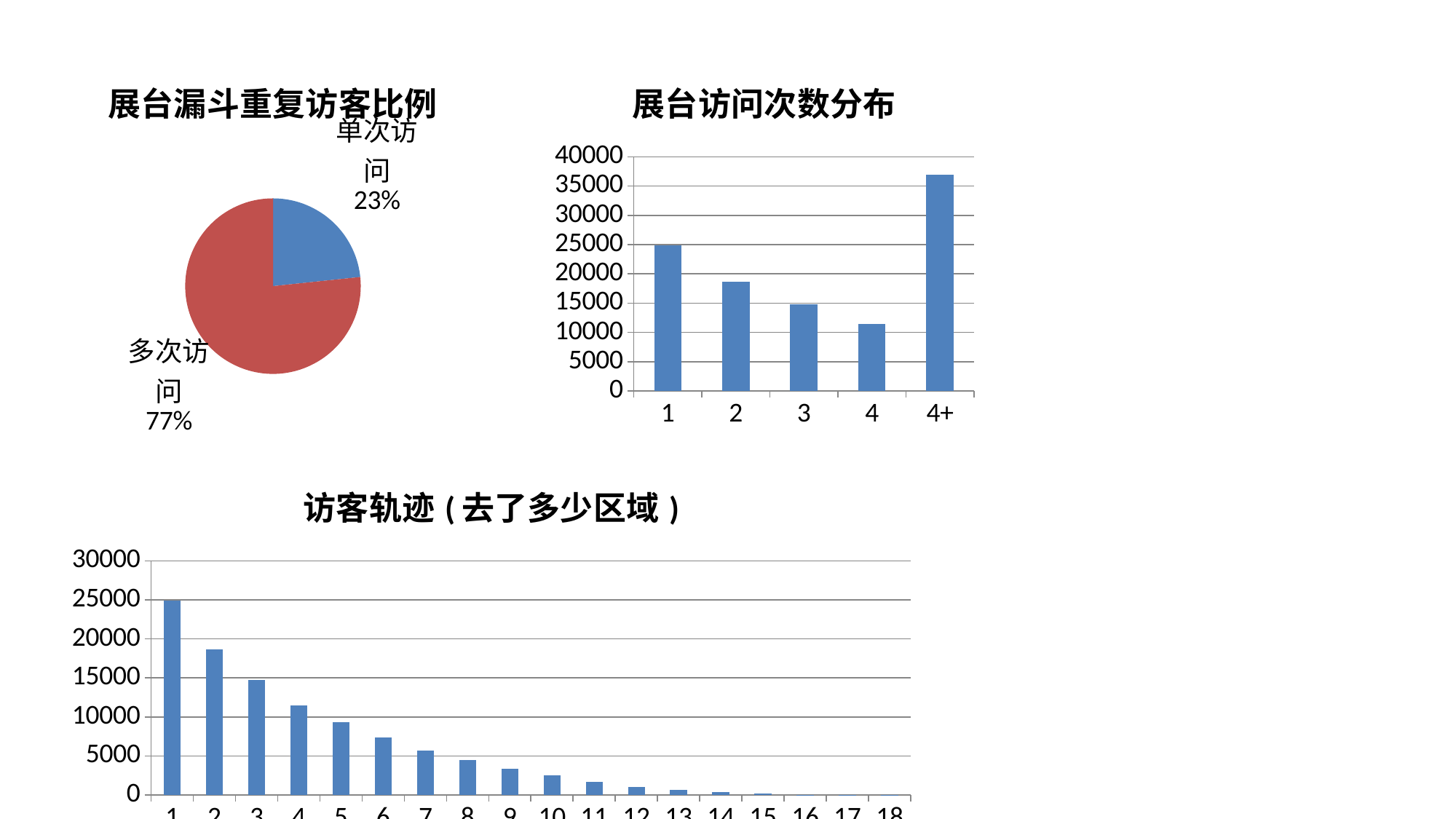
How many categories are shown on the x axis of the chart titled 访客轨迹（去了多少区域）? 18 What kind of chart is the one titled 访客轨迹（去了多少区域）? bar chart In the chart titled 展台访问次数分布, is the value for category 4+ greater or less than 35000? greater In the chart titled 展台访问次数分布, which category has the highest value? 4+ In the chart titled 展台漏斗重复访客比例, what percentage is shown for 单次访问? 23% In the chart titled 展台访问次数分布, which category has the lowest value? 4 In the chart titled 展台访问次数分布, is the value for category 1 greater or less than 20000? greater In the chart titled 展台漏斗重复访客比例, which slice is larger, 单次访问 or 多次访问? 多次访问 What kind of chart is the one titled 展台漏斗重复访客比例? pie chart In the chart titled 访客轨迹（去了多少区域）, do the values rise or fall as you move from category 1 to category 18? fall How many categories are shown on the x axis of the chart titled 展台访问次数分布? 5 In the chart titled 展台漏斗重复访客比例, what share of the pie does 多次访问 take? 77%